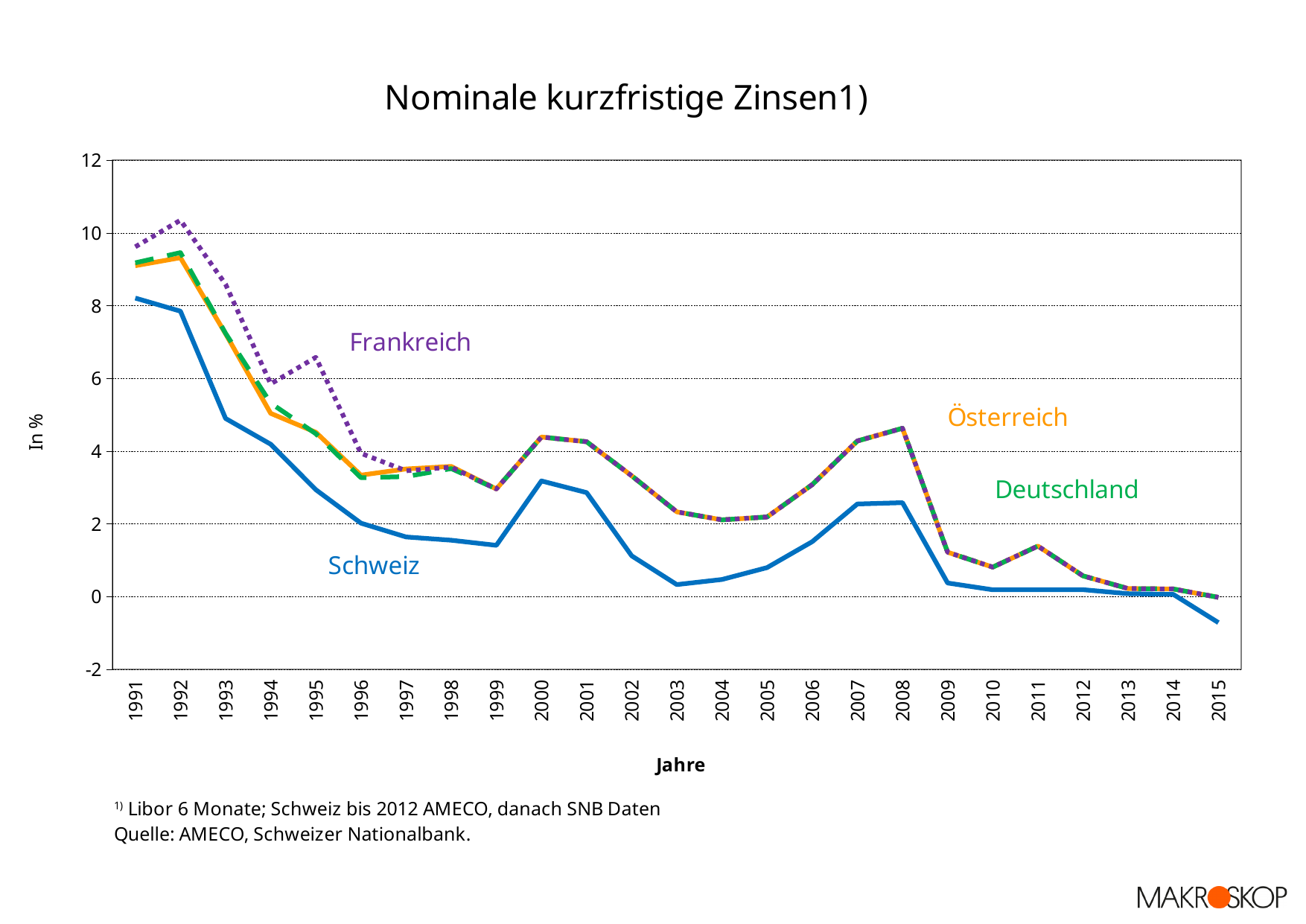
Do the values for Schweiz rise or fall from 1991 to 1999? fall Is the value for Frankreich in 1995 greater or less than 6? greater What kind of chart is shown on the slide? line chart How many years are shown on the x axis? 25 Is the value for Schweiz in 2003 greater or less than 2? less How many countries (series) are plotted in the chart? 4 Is the value for Frankreich in 1992 greater or less than 10? greater Which country has the highest value in 1992? Frankreich Which country has the lowest value in 2015? Schweiz What is the title of the chart? Nominale kurzfristige Zinsen1) What is the label of the y axis? In %